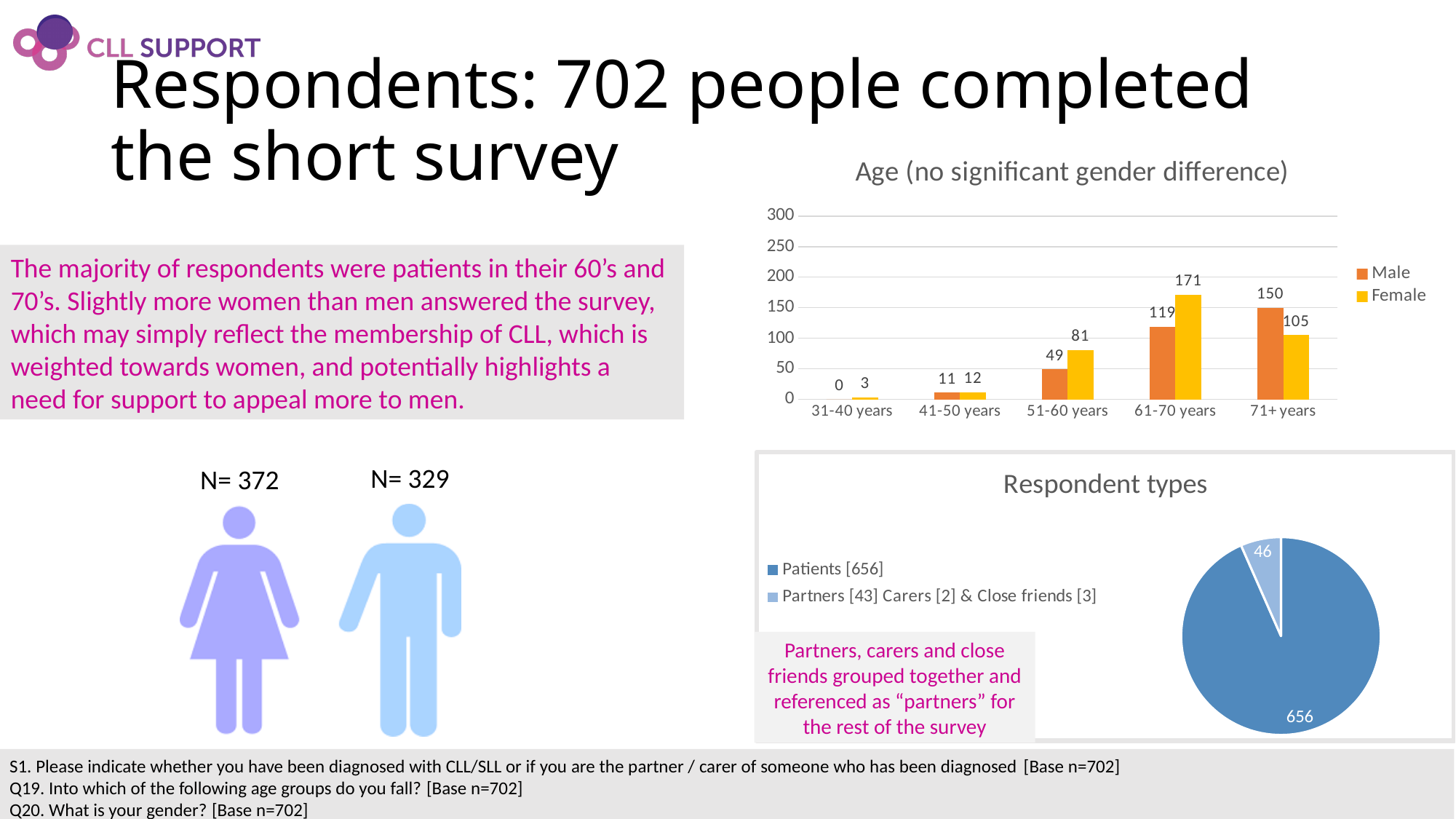
In the 'Age (no significant gender difference)' chart, for 71+ years, is the Male or Female value larger? Male In the 'Respondent types' pie chart, what is the value for the Partners, Carers & Close friends slice? 46 In the 'Age (no significant gender difference)' chart, what is the Female value for 61-70 years? 171 In the 'Age (no significant gender difference)' chart, which age group has the highest Female value? 61-70 years In the 'Age (no significant gender difference)' chart, what is the difference between the Female and Male values for 51-60 years? 32 How many age groups are shown on the x axis of the 'Age (no significant gender difference)' chart? 5 In the 'Respondent types' pie chart, what is the value for Patients? 656 What type of chart is 'Respondent types'? Pie chart In the 'Age (no significant gender difference)' chart, what is the Male value for 31-40 years? 0 In the 'Age (no significant gender difference)' chart, what is the Male value for 71+ years? 150 How many series does the legend of the 'Age (no significant gender difference)' chart list? 2 In the 'Age (no significant gender difference)' chart, which age group has the lowest Male value? 31-40 years